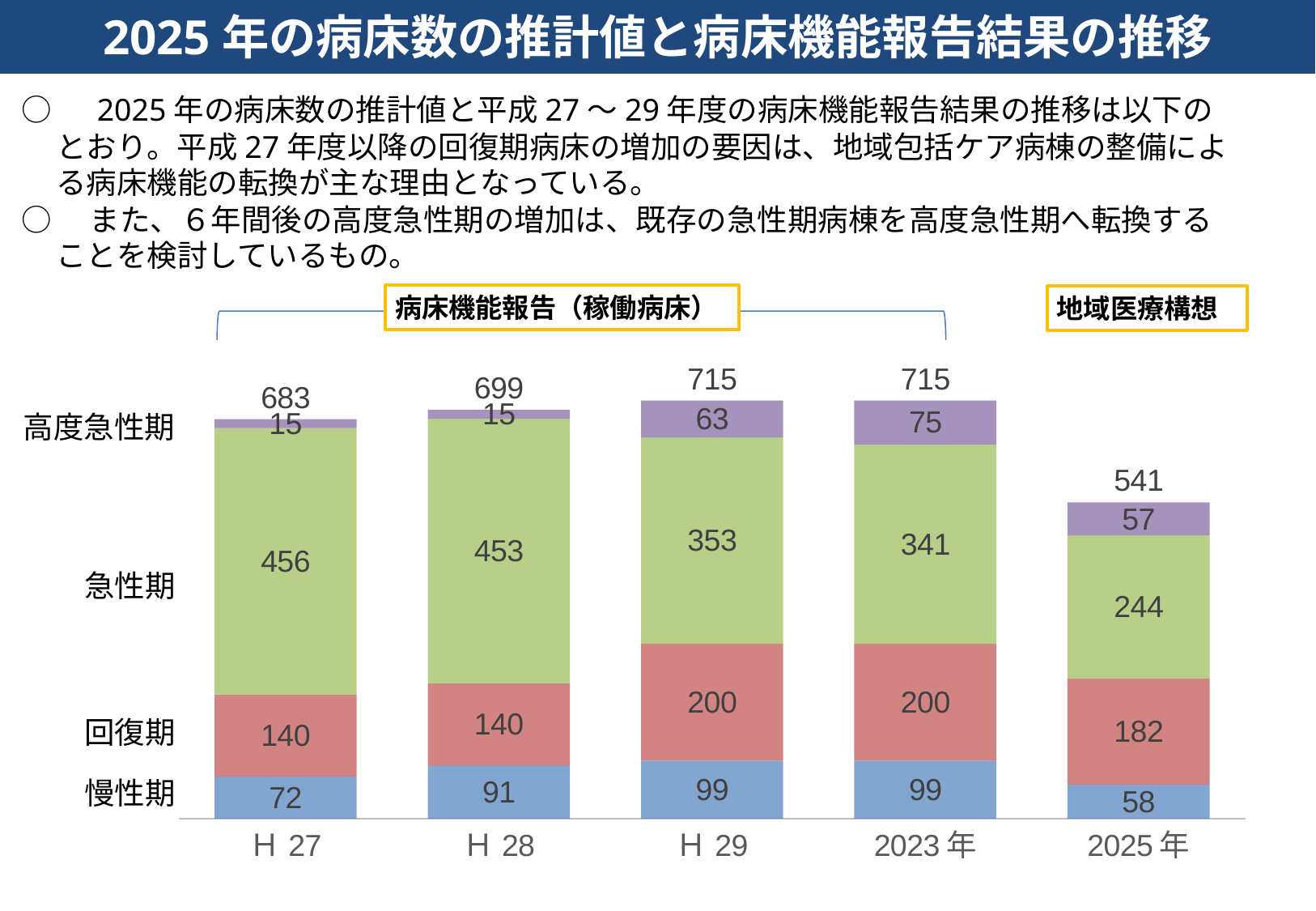
How many categories (years) are shown along the x axis of the chart? 5 What type of chart is shown on the slide? stacked bar chart Which is larger, the 慢性期 value for H 28 or for 2025年? H 28 How many series (bed function categories) are stacked in each bar? 4 What is the value of 急性期 for H 27? 456 What is the difference between the 回復期 values for H 29 and H 28? 60 Which year has the highest value for 急性期? H 27 What is the value of 高度急性期 for 2023年? 75 Which year has the lowest total number of beds? 2025年 What is the total of the stacked bar for H 28? 699 Which label appears in the box above the 2025年 bar? 地域医療構想 What is the value of 回復期 for 2025年? 182